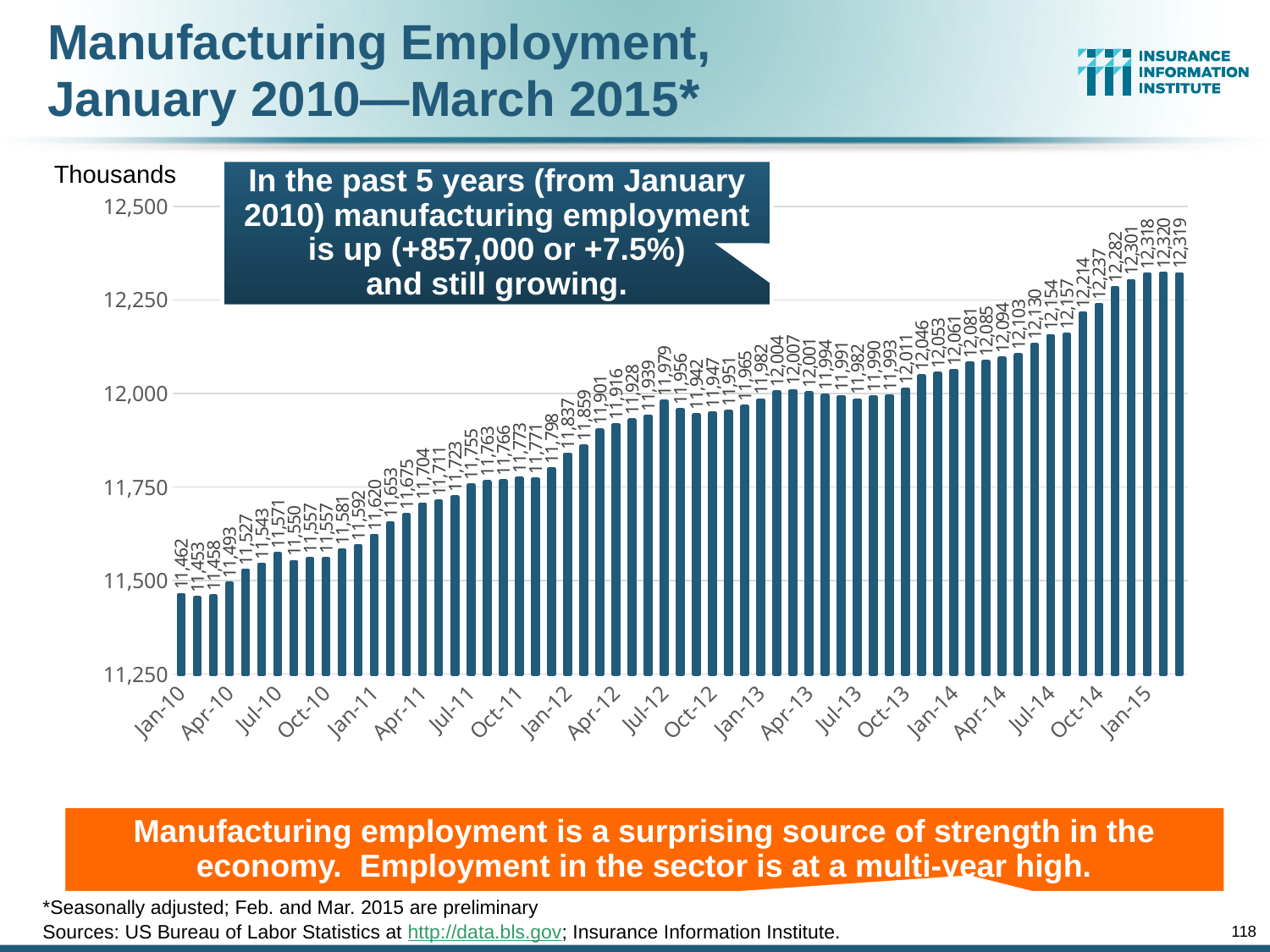
What is the value of the last bar (March 2015) in the chart? 12,319 Do the values generally rise or fall from Jan-10 to Jan-15? Rise Is the value for Jan-10 greater or less than 11,500? less What is the highest value labelled on the chart? 12,320 What is the manufacturing employment value for Jan-15? 12,318 What is the lowest value labelled on the chart? 11,453 What is the manufacturing employment value for Jan-10? 11,462 Which is larger, the value for Jan-12 or the value for Jan-11? Jan-12 What is the manufacturing employment value for Jan-13? 11,982 By how much does the value for Jan-14 exceed the value for Jan-13? 79 In what unit are the values on the vertical axis expressed? Thousands What kind of chart is shown on the slide? Bar chart